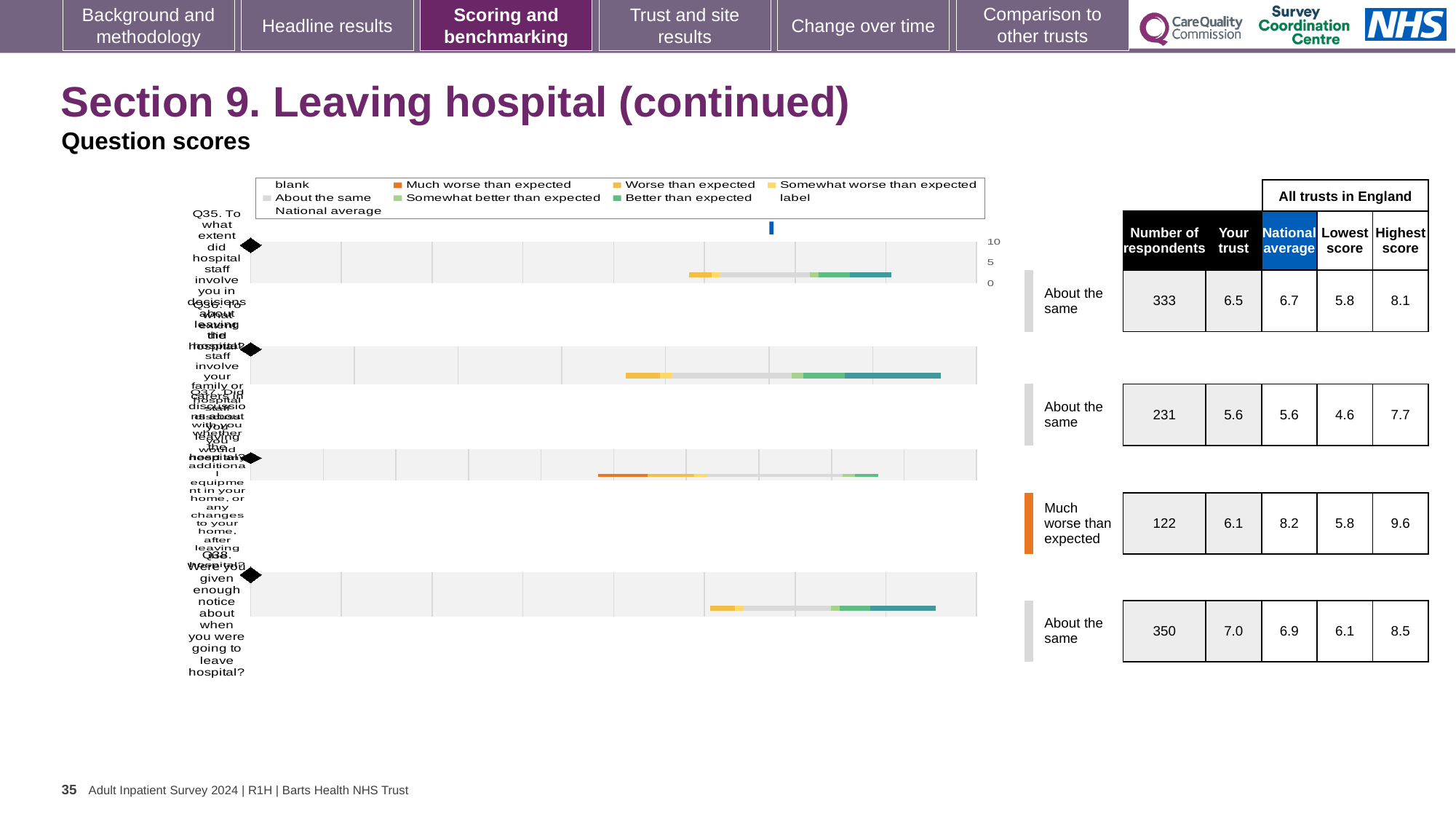
For the second chart from the top (Q36), what is the highest score among all trusts in England? 7.7 Across the four questions, which has the highest 'Your trust' score? Q38 (7.0) How many question charts (Q35 to Q38) are shown on the slide? 4 For Q35 (top chart), what is the national average score? 6.7 For Q38 (bottom chart), which is larger: the trust score or the national average? Your trust (7.0) For Q35 (top chart), what is the 'Your trust' score shown in the table? 6.5 For the third chart from the top (Q37), what benchmark category is the trust's score given? Much worse than expected What kind of chart is used to show the question scores on this slide? bar chart For the third chart from the top (Q37), what is the difference between the national average (8.2) and the trust score (6.1)? 2.1 For Q38 (bottom chart), how many respondents are listed? 350 Across the four questions, which has the lowest 'Your trust' score? Q36 (5.6) What colour in the legend represents 'Much worse than expected'? orange